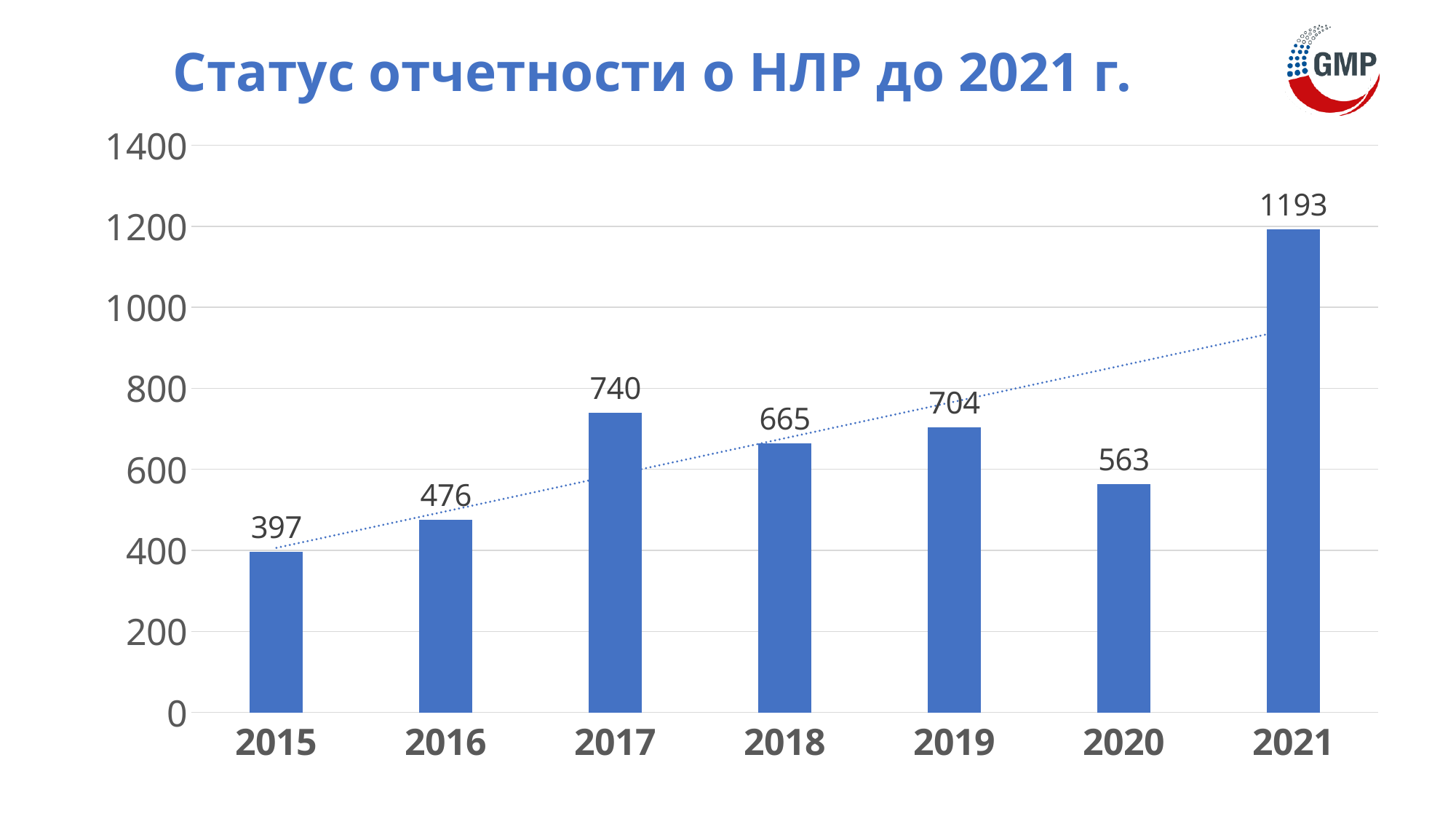
What is the value for 2018? 665 What is the title of the chart? Статус отчетности о НЛР до 2021 г. What is the difference between the values for 2017 and 2016? 264 Is the value for 2019 greater or less than 600? greater What is the value for 2020? 563 How many years are shown on the x axis? 7 Which year has the highest value? 2021 Which year has the lowest value? 2015 Which is larger, the value for 2017 or the value for 2019? 2017 What kind of chart is shown on the slide? bar chart What is the value for 2015? 397 What is the difference between the values for 2021 and 2020? 630